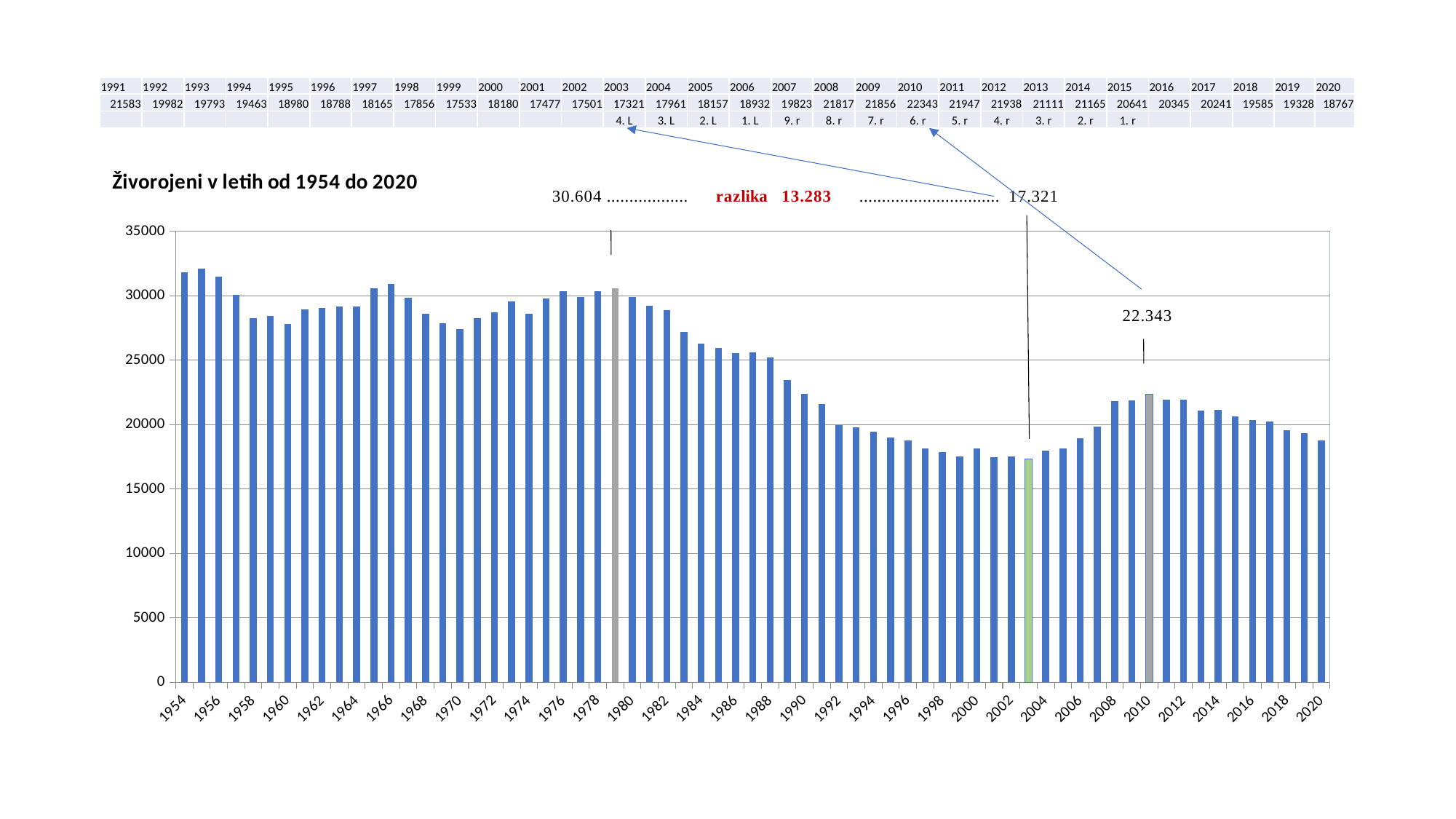
What is the difference between the value for 2010 and the value for 2020? 3576 What is the value for 2020? 18767 Do the values rise or fall from 1980 to 2003? fall What is the value for 2003 in the chart? 17321 What is the value for 2010? 22343 Is the value for 1990 greater or less than 25000? less What is the title of the chart? Živorojeni v letih od 1954 do 2020 What is the difference (razlika) between the 1979 value and the 2003 value? 13.283 Which year's bar is highlighted in green on the chart? 2003 What is the value for 1979 as annotated on the chart? 30.604 What kind of chart is shown on the slide? bar chart Which is larger, the value for 2010 or the value for 2020? 2010